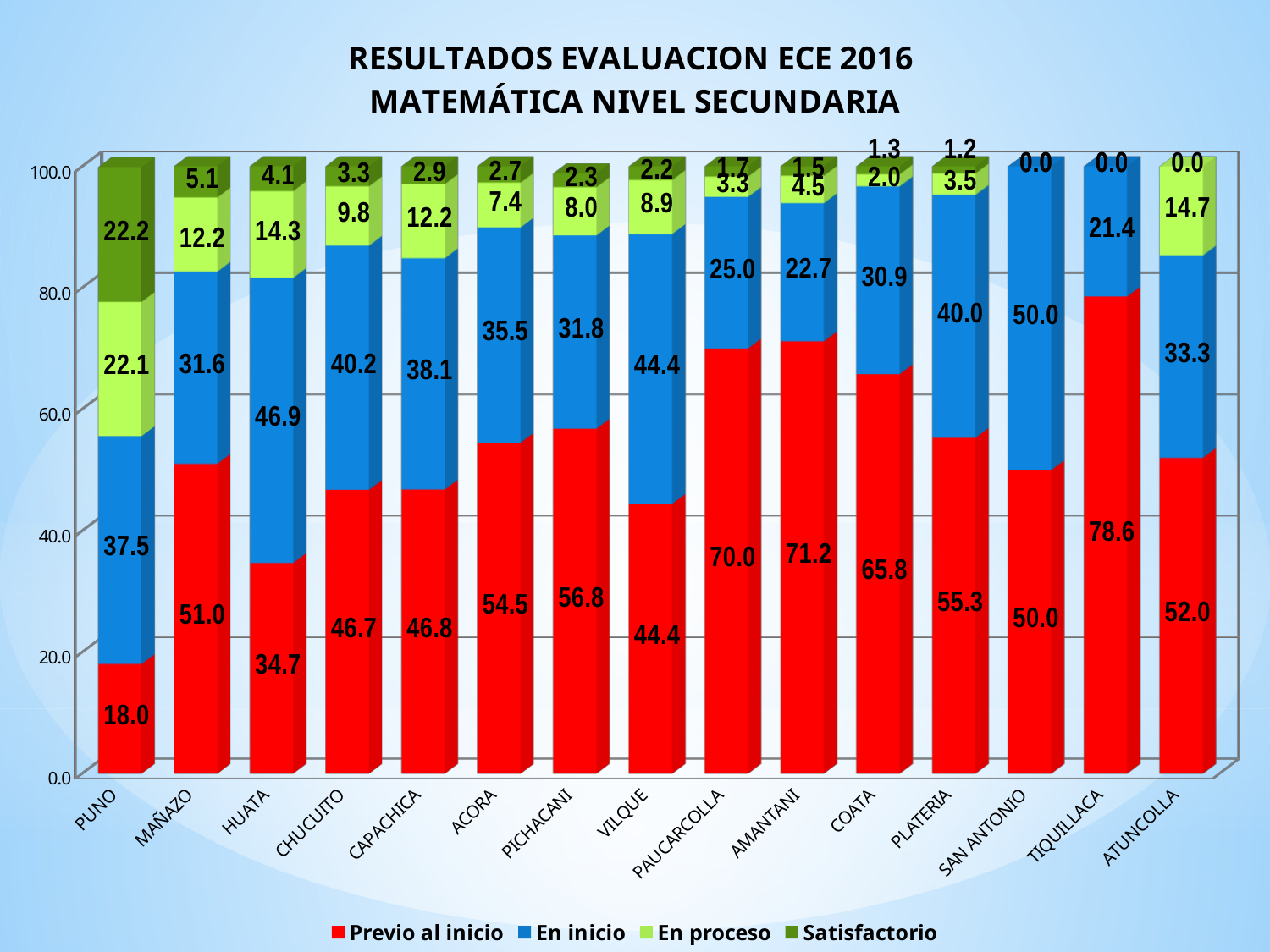
Which category has the highest value for Satisfactorio? PUNO Which series is shown in red in the legend? Previo al inicio What is the value of Satisfactorio for PUNO? 22.2 How many series does the legend list? 4 Which has a larger Previo al inicio value, PAUCARCOLLA or AMANTANI? AMANTANI What is the value of Previo al inicio for TIQUILLACA? 78.6 What is the difference between the En inicio values for HUATA and MAÑAZO? 15.3 Which category has the highest value for Previo al inicio? TIQUILLACA What is the value of En proceso for ATUNCOLLA? 14.7 How many categories are shown on the x axis? 15 Which category has the lowest value for Previo al inicio? PUNO What kind of chart is shown on the slide? Stacked bar chart